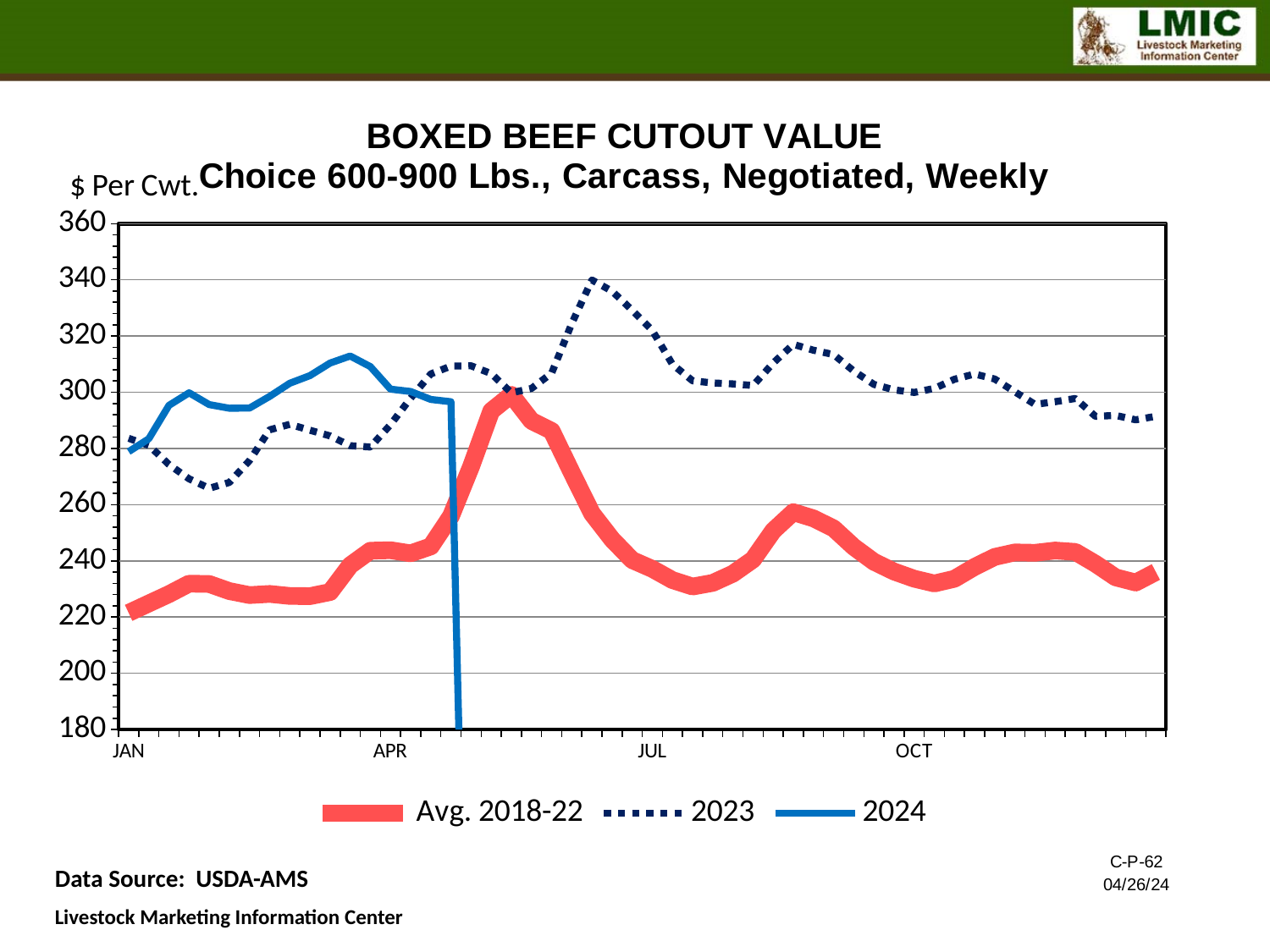
What is the title of the chart? BOXED BEEF CUTOUT VALUE, Choice 600-900 Lbs., Carcass, Negotiated, Weekly Is the value of the 2023 series in early February greater or less than 280? less In January, which series is higher: 2023 or Avg. 2018-22? 2023 How many series does the legend list? 3 Is the peak value of the 2023 series in late June greater or less than 320? greater Does the 2024 series rise or fall from January to early March? rise In April, which series is higher: 2024 or Avg. 2018-22? 2024 What kind of chart is shown on the slide? line chart Which series reaches the highest value shown on the chart? 2023 Is the value of the Avg. 2018-22 series at the start of August greater or less than 240? less Which series is drawn as a dotted line? 2023